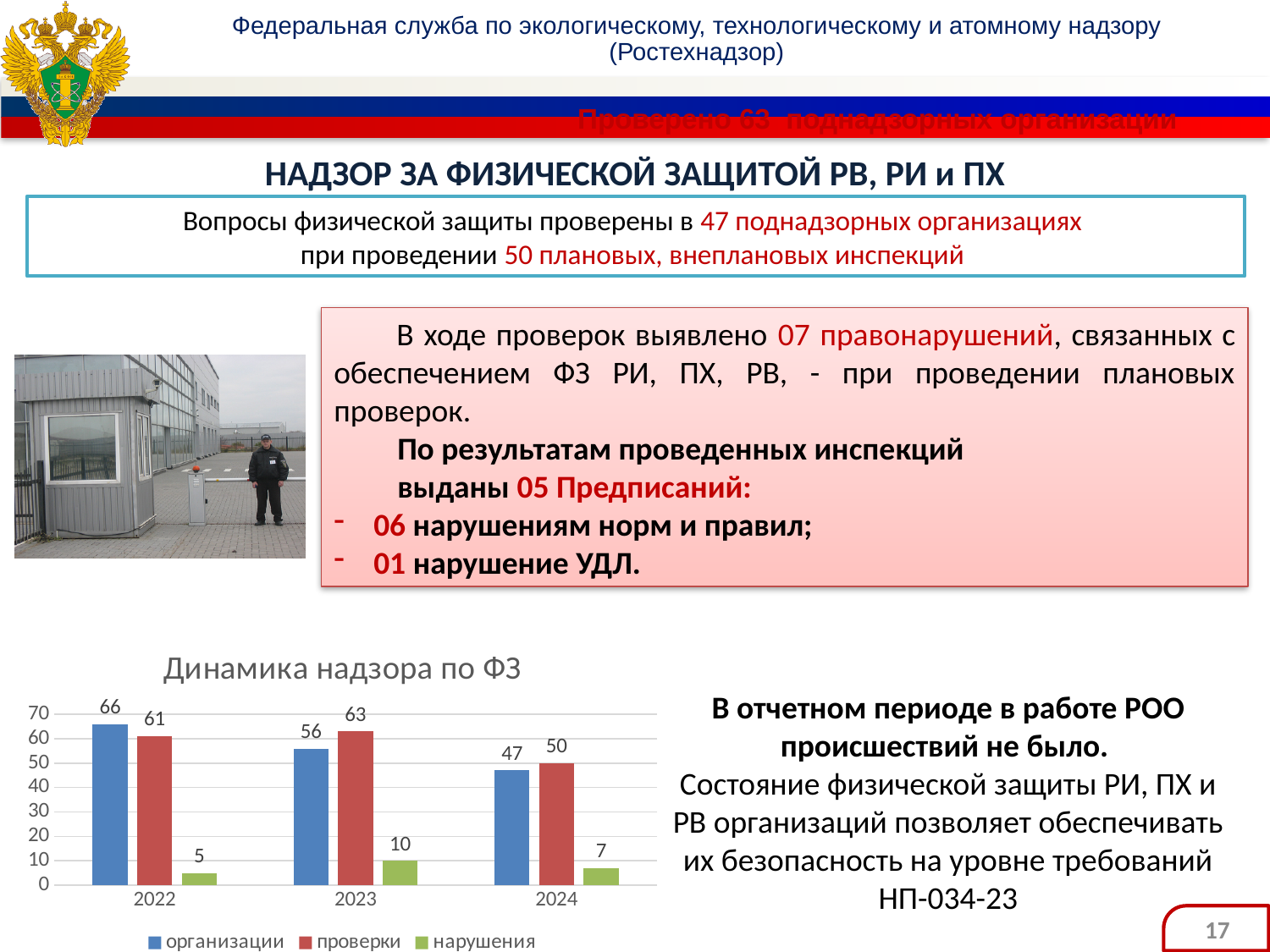
How many series does the legend list? 3 What is the value for организации in 2022? 66 How many years are shown on the x axis? 3 Does the value for организации rise or fall from 2022 to 2024? fall What is the title of the chart? Динамика надзора по ФЗ What is the difference between проверки and организации in 2024? 3 What is the value for нарушения in 2024? 7 In which year is the value for нарушения highest? 2023 In which year is the value for организации lowest? 2024 What is the value for проверки in 2023? 63 Which is larger in 2022: организации or проверки? организации What kind of chart is shown? bar chart